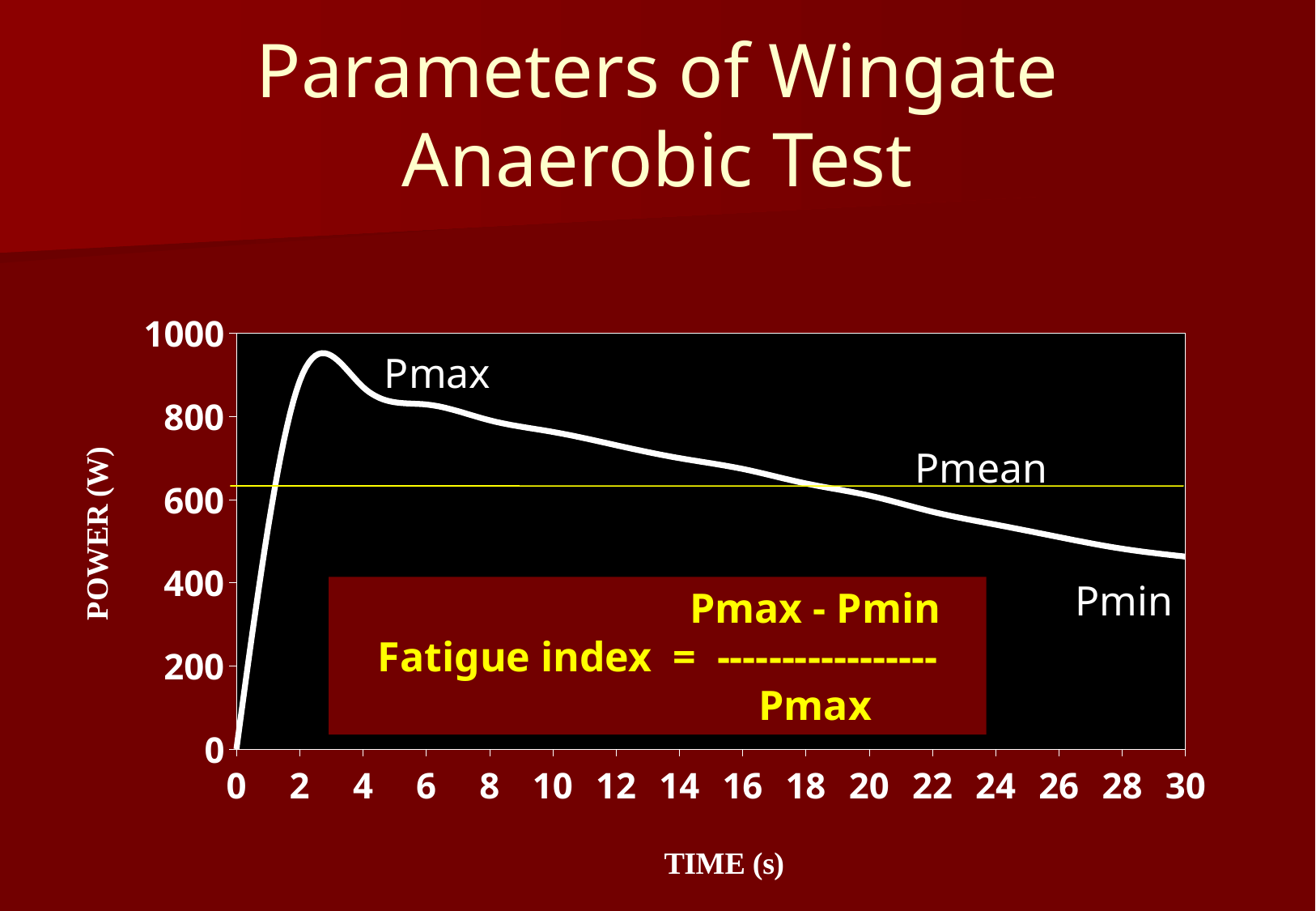
What is the label of the y axis of the chart? POWER (W) After reaching its peak, does the power curve rise or fall as time increases? fall Is the peak power value (Pmax) on the curve greater or less than 800? greater What is the label of the x axis of the chart? TIME (s) Is the horizontal Pmean line greater or less than 800? less Is the power value at 30 s (Pmin) greater or less than 600? less Which is larger, the power at 4 s or the power at 26 s? the power at 4 s What is the highest value shown on the y axis of the chart? 1000 What kind of chart is shown on the slide? line chart